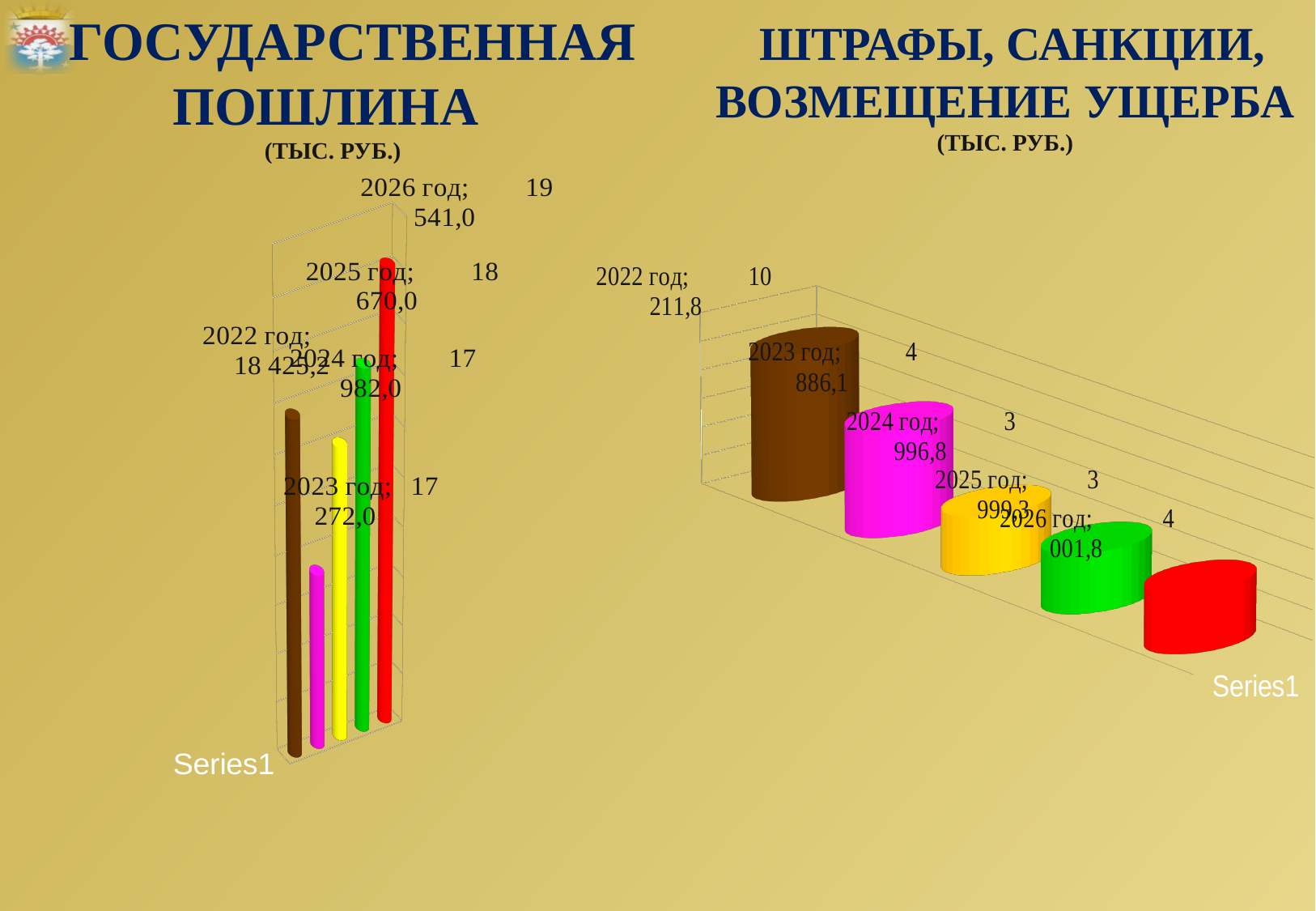
On the left chart (ГОСУДАРСТВЕННАЯ ПОШЛИНА), which is larger: the value for 2024 год or 2025 год? 2025 год On the right chart (ШТРАФЫ, САНКЦИИ, ВОЗМЕЩЕНИЕ УЩЕРБА), what is the difference between the values for 2022 год and 2023 год? 5 325,7 On the left chart (ГОСУДАРСТВЕННАЯ ПОШЛИНА), which year has the highest value? 2026 год On the left chart (ГОСУДАРСТВЕННАЯ ПОШЛИНА), which year has the lowest value? 2023 год On the left chart (ГОСУДАРСТВЕННАЯ ПОШЛИНА), what is the value for 2023 год? 17 272,0 On the right chart (ШТРАФЫ, САНКЦИИ, ВОЗМЕЩЕНИЕ УЩЕРБА), do the values rise or fall from 2022 год to 2024 год? fall On the left chart (ГОСУДАРСТВЕННАЯ ПОШЛИНА), what is the value for 2026 год? 19 541,0 On the right chart (ШТРАФЫ, САНКЦИИ, ВОЗМЕЩЕНИЕ УЩЕРБА), which year has the highest value? 2022 год On the right chart (ШТРАФЫ, САНКЦИИ, ВОЗМЕЩЕНИЕ УЩЕРБА), which is larger: the value for 2023 год or 2026 год? 2023 год On the left chart (ГОСУДАРСТВЕННАЯ ПОШЛИНА), what is the difference between the values for 2026 год and 2025 год? 871,0 On the right chart (ШТРАФЫ, САНКЦИИ, ВОЗМЕЩЕНИЕ УЩЕРБА), what is the value for 2022 год? 10 211,8 On the right chart (ШТРАФЫ, САНКЦИИ, ВОЗМЕЩЕНИЕ УЩЕРБА), how many years are plotted? 5